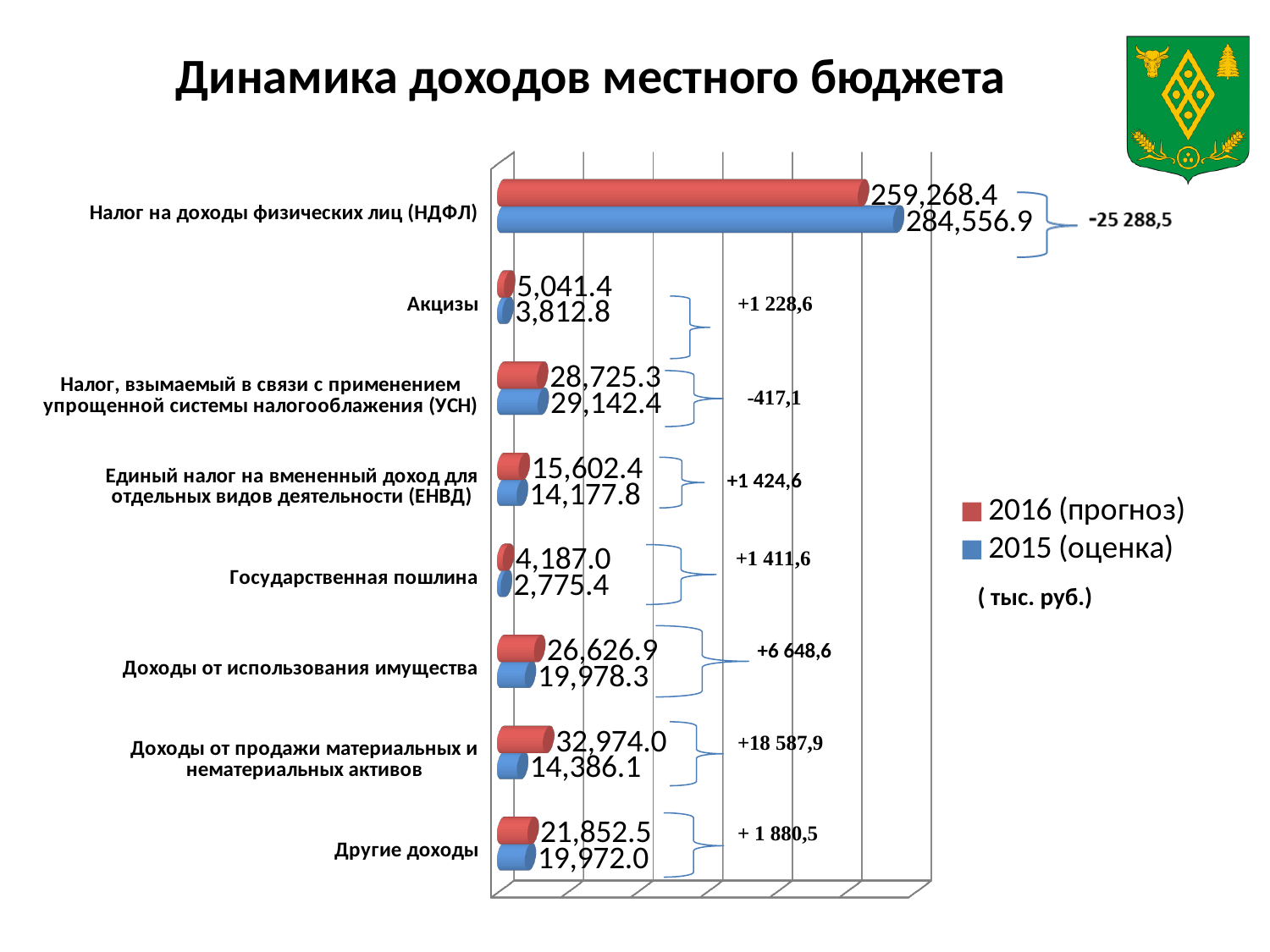
What kind of chart is shown on the slide? Bar chart How many series does the legend list? 2 What is the title of the chart? Динамика доходов местного бюджета What is the difference between the 2016 (прогноз) and 2015 (оценка) values for Доходы от продажи материальных и нематериальных активов? 18,587.9 Which category has the lowest 2016 (прогноз) value? Государственная пошлина What is the 2016 (прогноз) value for Налог на доходы физических лиц (НДФЛ)? 259,268.4 What is the 2015 (оценка) value for Государственная пошлина? 2,775.4 What is the 2016 (прогноз) value for Доходы от продажи материальных и нематериальных активов? 32,974.0 Which is larger for Налог, взымаемый в связи с применением упрощенной системы налогообложения (УСН): the 2016 (прогноз) value or the 2015 (оценка) value? 2015 (оценка) How many categories are shown on the chart? 8 What is the 2015 (оценка) value for Акцизы? 3,812.8 Which category has the highest 2015 (оценка) value? Налог на доходы физических лиц (НДФЛ)